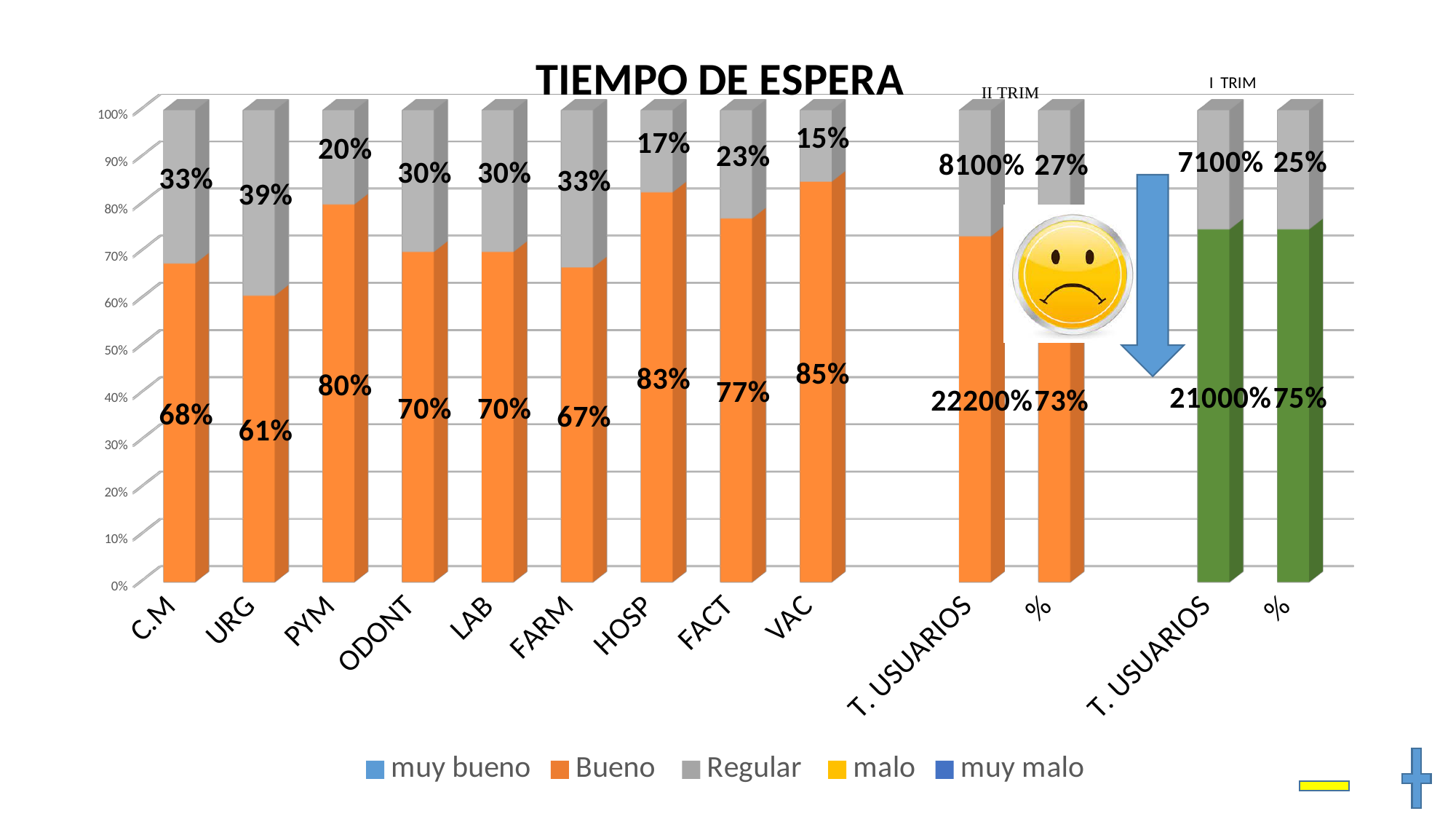
Which of the nine service categories (C.M through VAC) has the highest Bueno value? VAC What is the Regular value for the % bar under I TRIM? 25% Is the Bueno value for FARM greater or less than 60%? greater Which has a larger Regular value, FACT or HOSP? FACT What is the Regular value for URG? 39% What is the difference between the Bueno values for PYM and URG? 19% How many series does the legend list? 5 Which of the nine service categories (C.M through VAC) has the lowest Bueno value? URG What kind of chart is shown on the slide? Stacked bar chart What is the title of the chart? TIEMPO DE ESPERA What is the Bueno value for VAC? 85% What is the Bueno value for HOSP? 83%